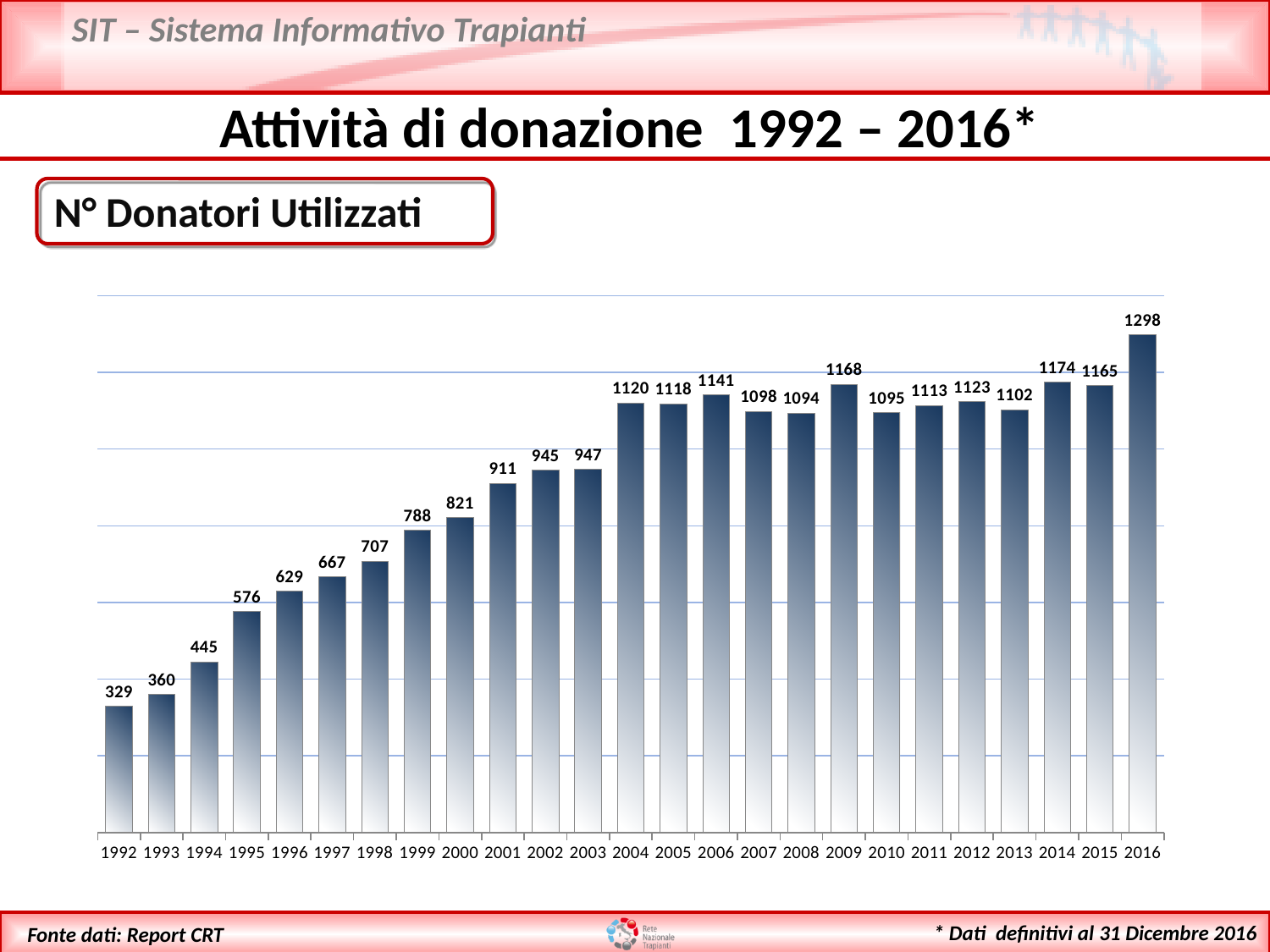
What is the number of donors used (N° Donatori Utilizzati) in 1992? 329 Which year has the highest number of donors used? 2016 What is the value shown for 2009? 1168 Which year has the lowest number of donors used? 1992 What is the value shown for 2016? 1298 What is the value shown for 2003? 947 What is the difference between the values for 2016 and 2015? 133 Which year has a larger value, 2009 or 2014? 2014 Do the values generally rise or fall from 1992 to 2016? Rise How many years are shown on the x axis of the chart? 25 What is the difference between the values for 2004 and 1992? 791 What kind of chart is shown on the slide? Bar chart